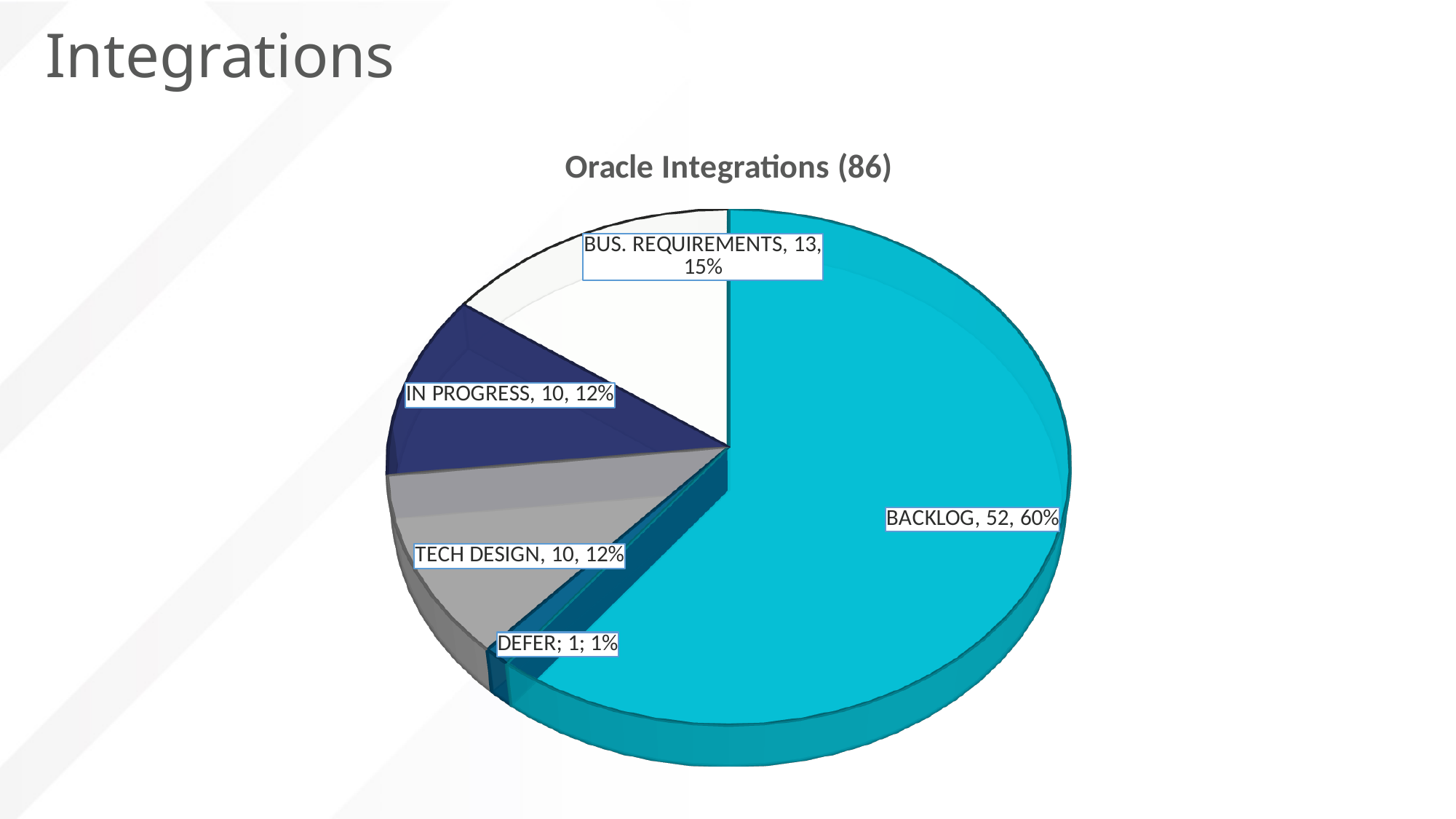
What kind of chart is shown on the slide? Pie chart What is the value for DEFER? 1 Which category has the smallest slice? DEFER What share of the pie does BACKLOG represent? 60% What is the difference between the values for BACKLOG and BUS. REQUIREMENTS? 39 What share of the pie does IN PROGRESS represent? 12% How many slices does the pie chart have? 5 Which category has the largest slice? BACKLOG What is the value for BUS. REQUIREMENTS? 13 Which is larger, the value for BUS. REQUIREMENTS or the value for TECH DESIGN? BUS. REQUIREMENTS What is the value for BACKLOG? 52 What is the title of the chart? Oracle Integrations (86)